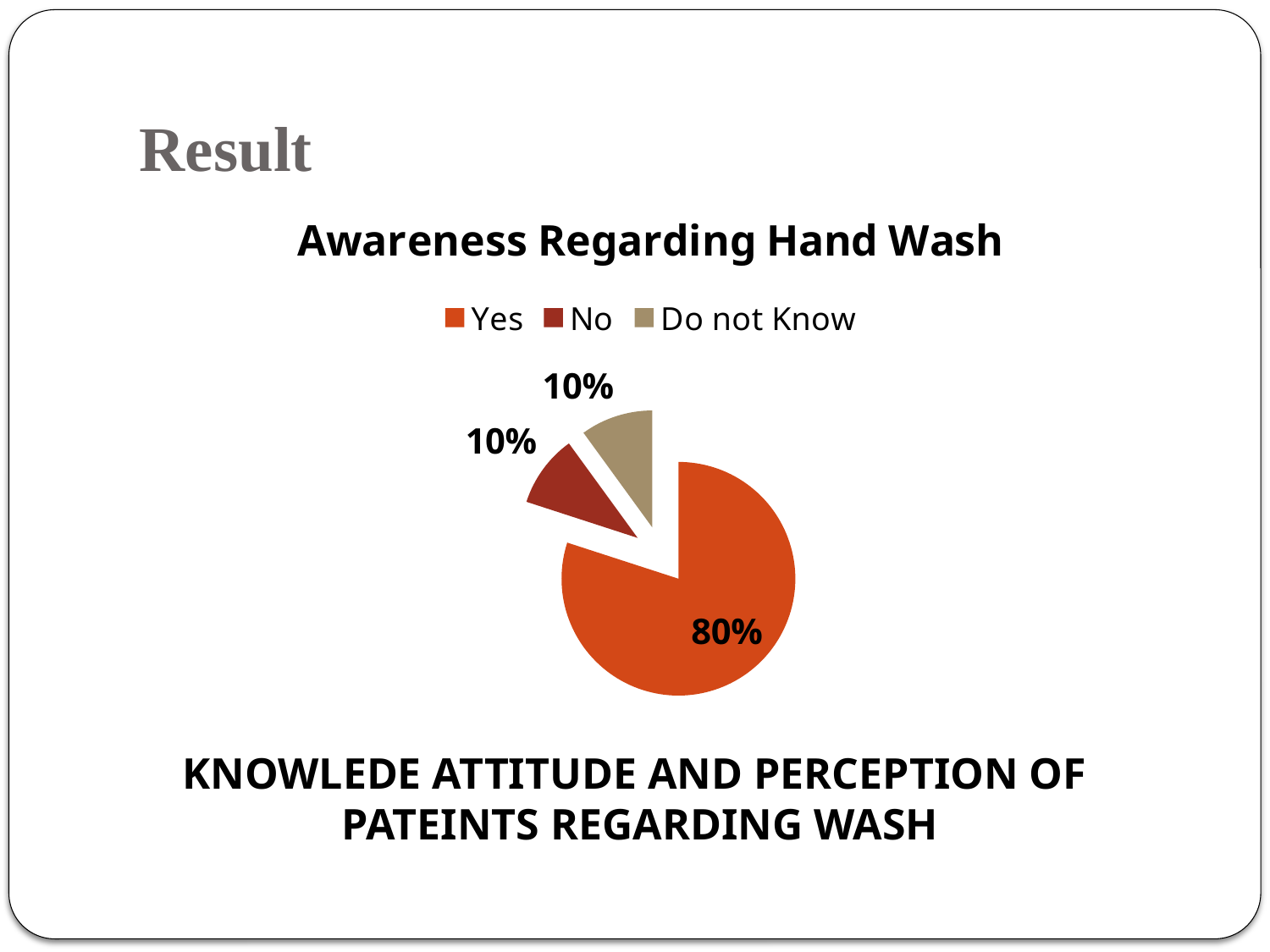
What type of chart is shown on the slide? pie chart What percentage is shown for the 'No' slice? 10% What colour is the 'Yes' slice in the pie chart? orange How many categories does the legend list? 3 What percentage is shown for the 'Do not Know' slice? 10% What is the difference between the 'Yes' share and the 'No' share? 70% Which category has the largest share of the pie? Yes What percentage of the pie is labelled for the 'Yes' slice? 80% Which is larger, the 'Yes' slice or the 'Do not Know' slice? Yes How many slices does the pie chart have? 3 What is the combined share of the 'No' and 'Do not Know' slices? 20% What is the title of the chart? Awareness Regarding Hand Wash